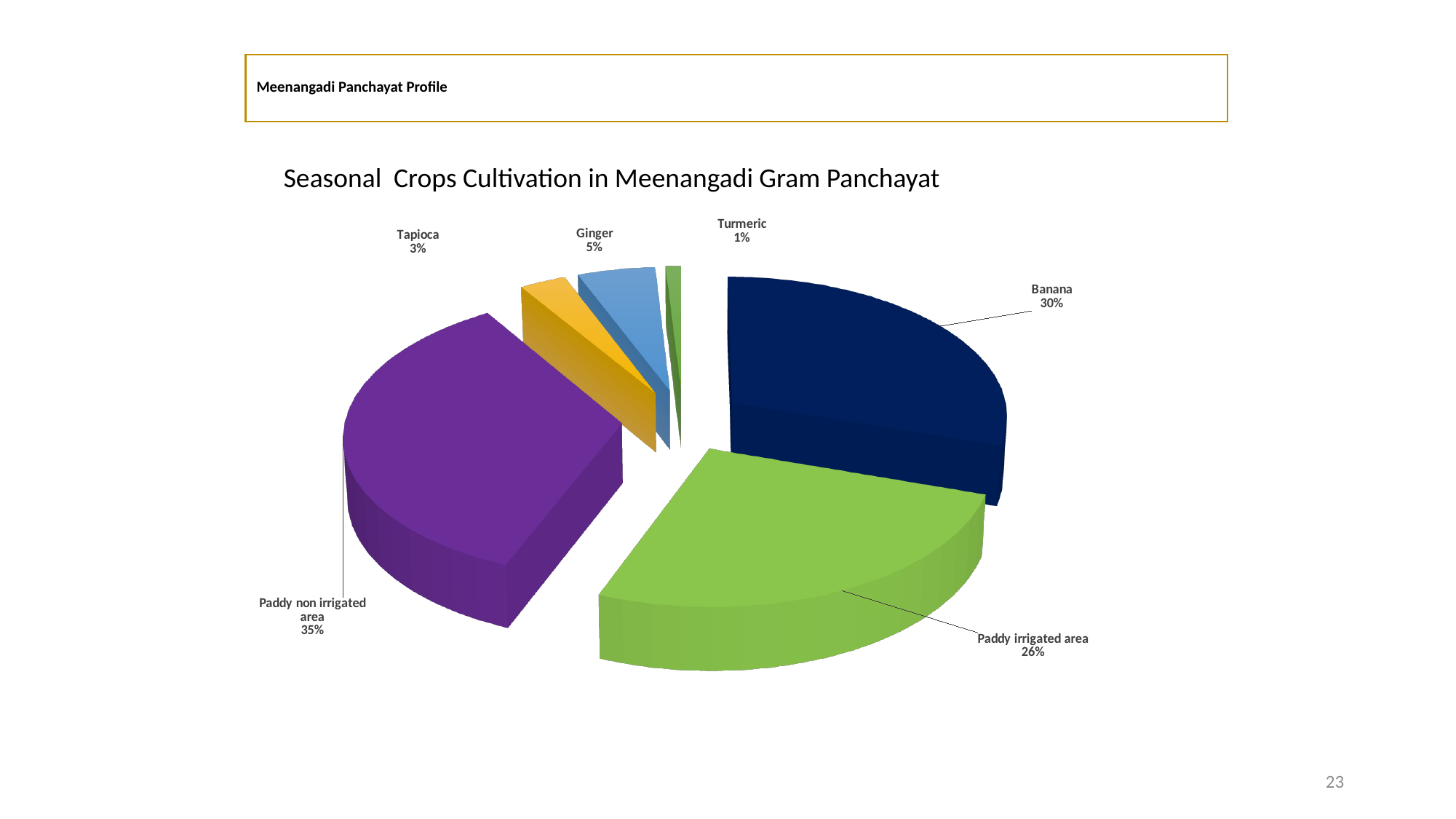
What is the difference in percentage points between Paddy non irrigated area and Paddy irrigated area? 9 What is the value shown for Paddy non irrigated area? 35% Which crop has the smallest slice of the pie? Turmeric Which is larger, the share for Banana or the share for Paddy irrigated area? Banana What share of the pie does Banana account for? 30% What percentage is shown for Ginger? 5% What kind of chart is shown on the slide? Pie chart What is the combined share of Tapioca and Ginger? 8% How many crop categories are shown in the pie chart? 6 Which crop has the largest slice of the pie? Paddy non irrigated area What colour is the Banana slice? Dark blue What is the title of the chart? Seasonal Crops Cultivation in Meenangadi Gram Panchayat